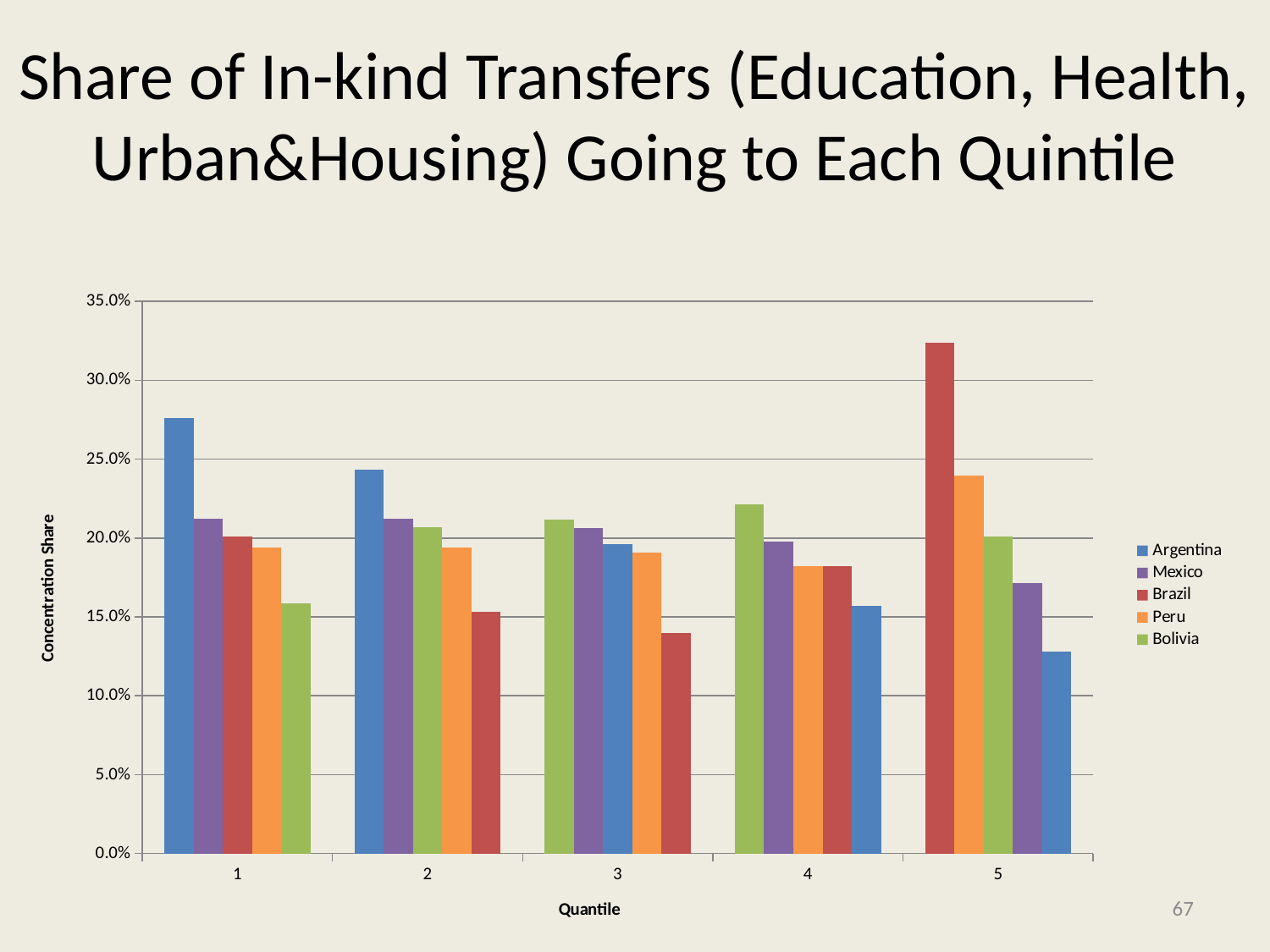
Which country has the highest share in quintile 1? Argentina Is the value for Brazil in quintile 3 greater or less than 15.0%? less Which country has the highest share in quintile 5? Brazil Which country has the lowest share in quintile 5? Argentina How many quintile categories are shown on the x axis? 5 Do the values for Argentina rise or fall from quintile 1 to quintile 5? Fall Which country has the lowest share in quintile 1? Bolivia What kind of chart is shown on the slide? Bar chart In quintile 4, which is larger: the value for Bolivia or the value for Argentina? Bolivia How many series does the legend list? 5 Is the value for Argentina in quintile 1 greater or less than 25.0%? greater Is the value for Brazil in quintile 5 greater or less than 30.0%? greater